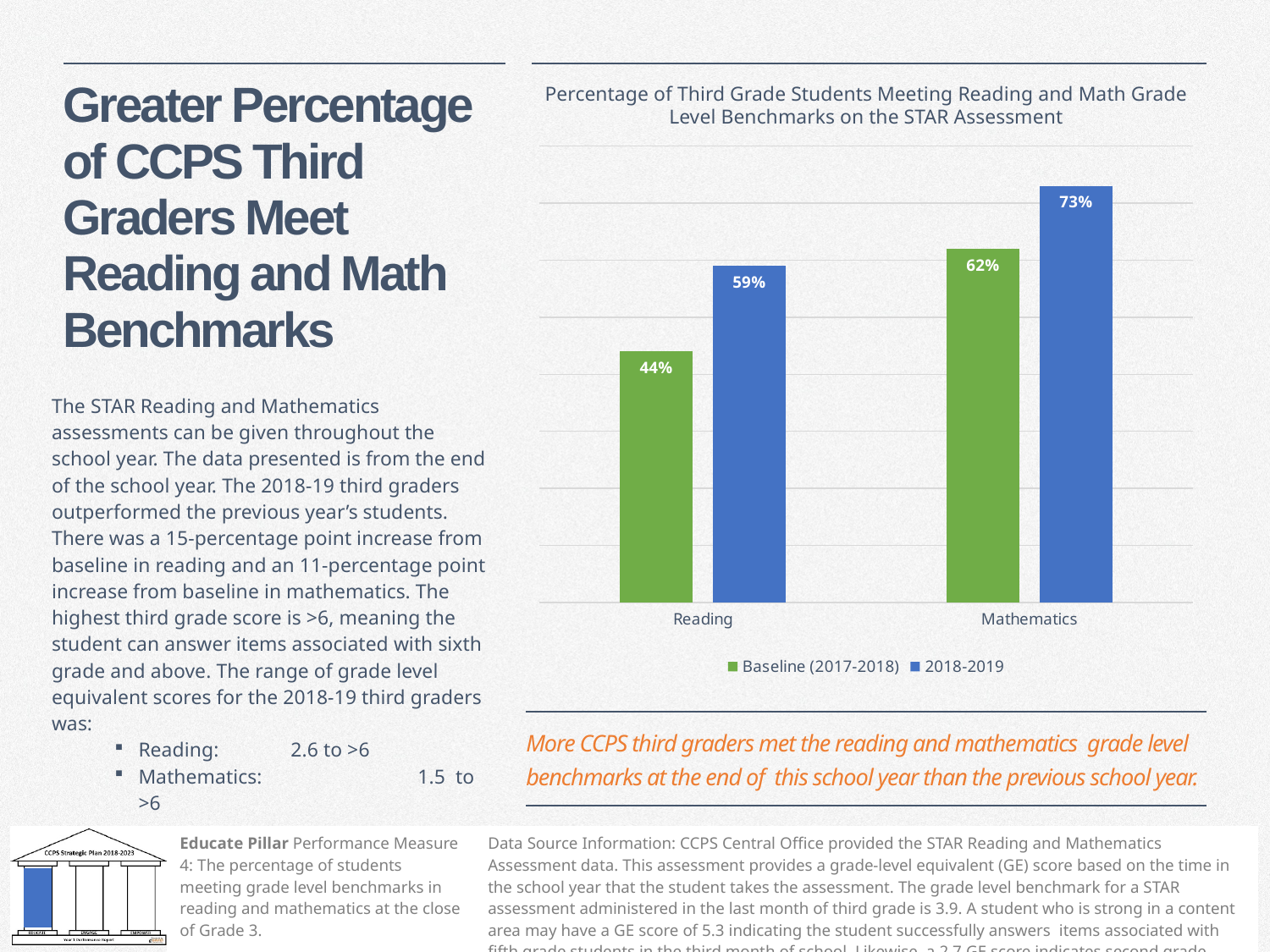
Which is larger: the Baseline (2017-2018) value for Mathematics or the 2018-2019 value for Reading? Baseline (2017-2018) value for Mathematics Which bar on the chart has the lowest value? Reading, Baseline (2017-2018) What is the 2018-2019 value for Reading? 59% What is the difference between the 2018-2019 and Baseline (2017-2018) values for Mathematics? 11 percentage points What is the Baseline (2017-2018) value for Mathematics? 62% What percentage of third grade students met the mathematics benchmark in 2018-2019? 73% How many series does the chart legend list? 2 What is the difference between the 2018-2019 and Baseline (2017-2018) values for Reading? 15 percentage points What percentage of third grade students met the reading benchmark in the Baseline (2017-2018) series? 44% What type of chart is shown on the slide? Bar chart How many categories are shown on the x axis of the chart? 2 Which category has the highest value in the 2018-2019 series? Mathematics